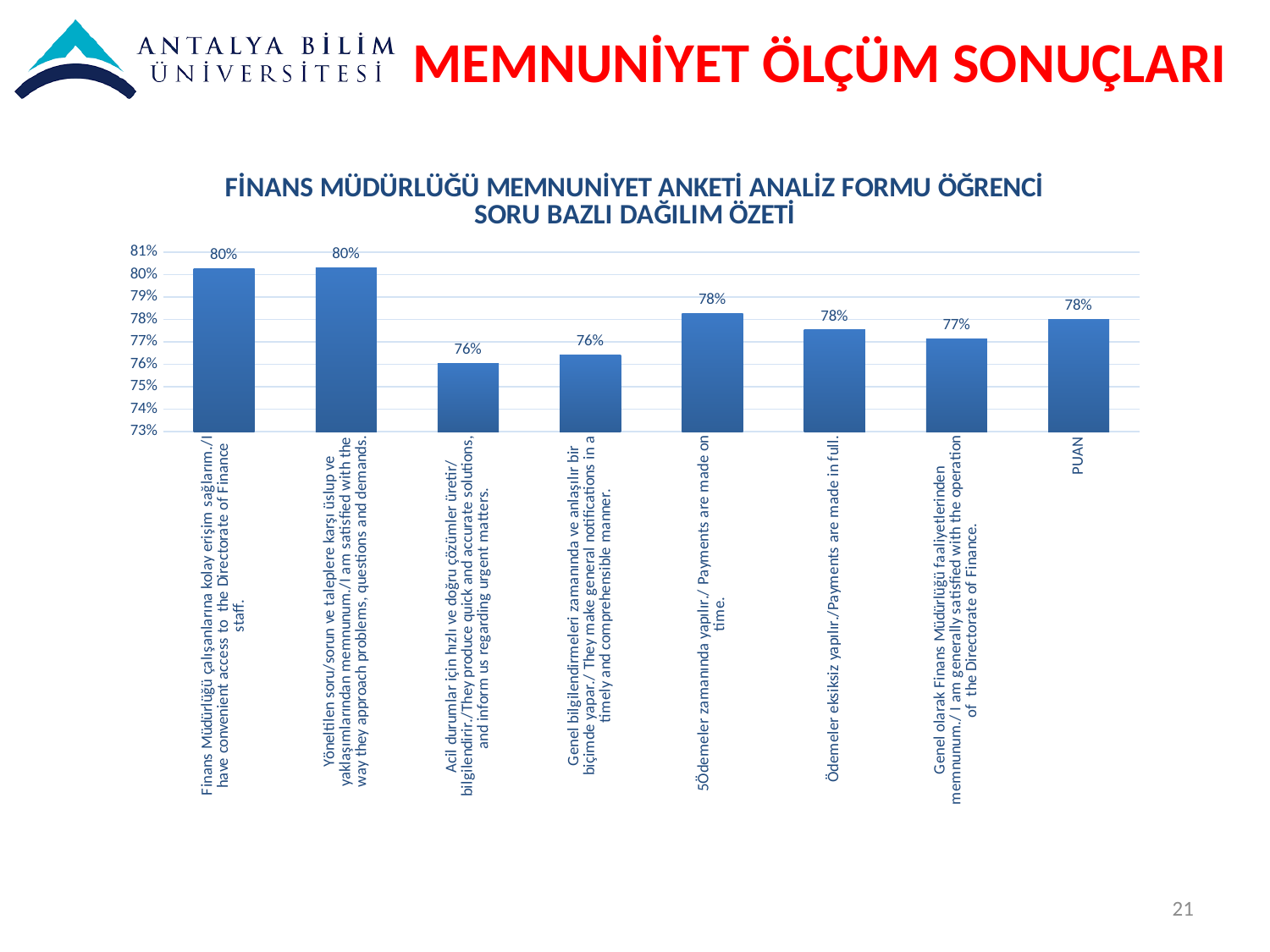
Which is larger: the value for "I have convenient access to the Directorate of Finance staff." or the value for "I am generally satisfied with the operation of the Directorate of Finance."? I have convenient access to the Directorate of Finance staff. What is the value for "Genel olarak Finans Müdürlüğü faaliyetlerinden memnunum./ I am generally satisfied with the operation of the Directorate of Finance."? 77% How many bars are plotted in the chart? 8 What is the highest value shown in the chart? 80% What is the title of the chart? FİNANS MÜDÜRLÜĞÜ MEMNUNİYET ANKETİ ANALİZ FORMU ÖĞRENCİ SORU BAZLI DAĞILIM ÖZETİ What type of chart is shown on the slide? bar chart What is the difference between the value for "I have convenient access to the Directorate of Finance staff." and the value for "They produce quick and accurate solutions, and inform us regarding urgent matters."? 4 percentage points What is the value of the PUAN bar? 78% Is the value for PUAN greater or less than 75%? greater What is the value for "Acil durumlar için hızlı ve doğru çözümler üretir/ bilgilendirir./They produce quick and accurate solutions, and inform us regarding urgent matters."? 76% What is the lowest value shown in the chart? 76% What is the value for "Ödemeler eksiksiz yapılır./Payments are made in full."? 78%